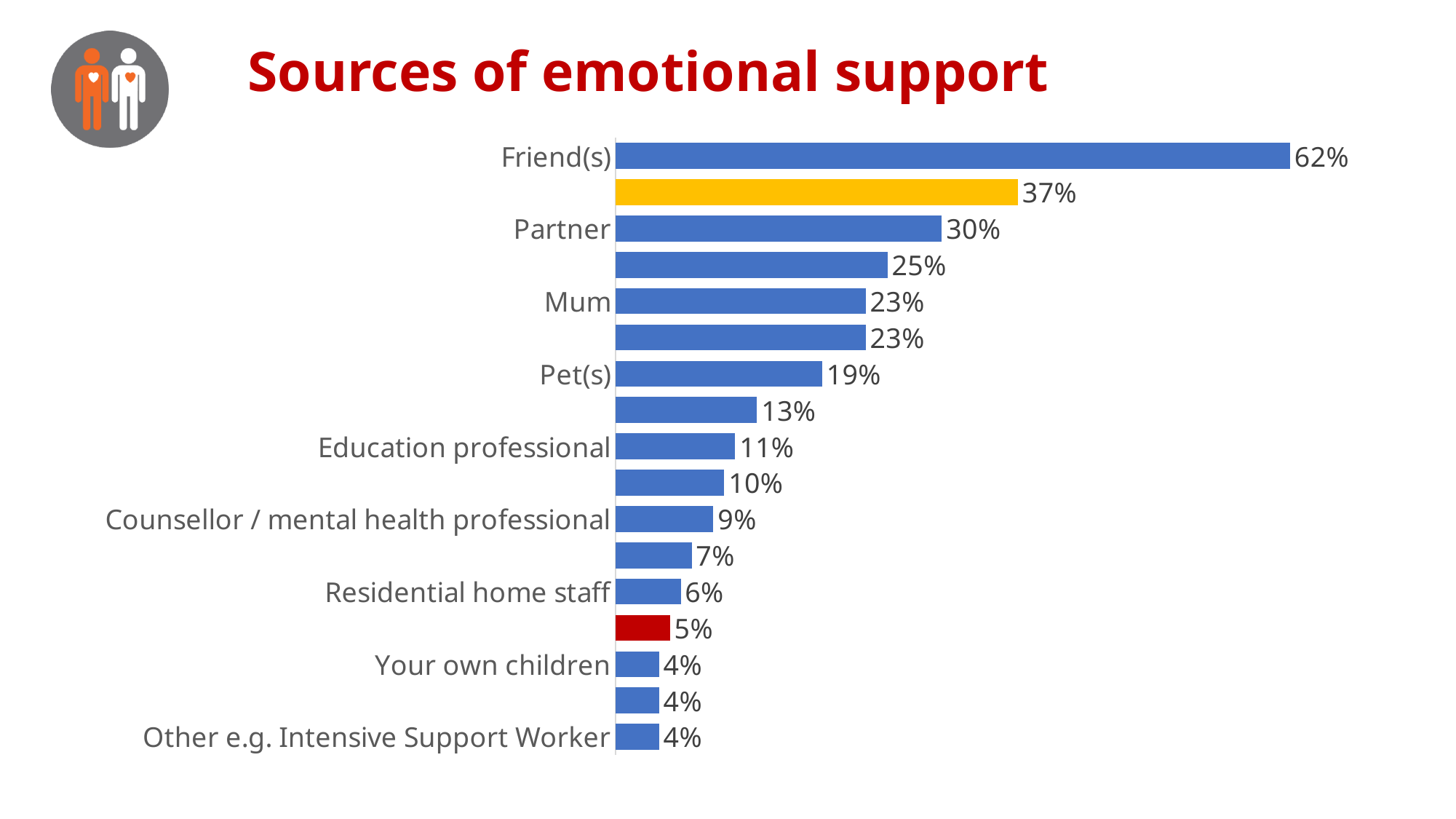
What is the value shown for Counsellor / mental health professional? 9% What is the value shown for Partner? 30% What type of chart is shown on the slide? Bar chart What is the value shown for Pet(s)? 19% How many bars are plotted in the chart? 17 Which source of emotional support has the highest value? Friend(s) What value is labelled on the orange bar? 37% What is the value shown for Mum? 23% What is the difference between the values for Friend(s) and Partner? 32% Which has a larger value, Mum or Pet(s)? Mum What percentage of respondents cited Friend(s) as a source of emotional support? 62% What is the value shown for Residential home staff? 6%